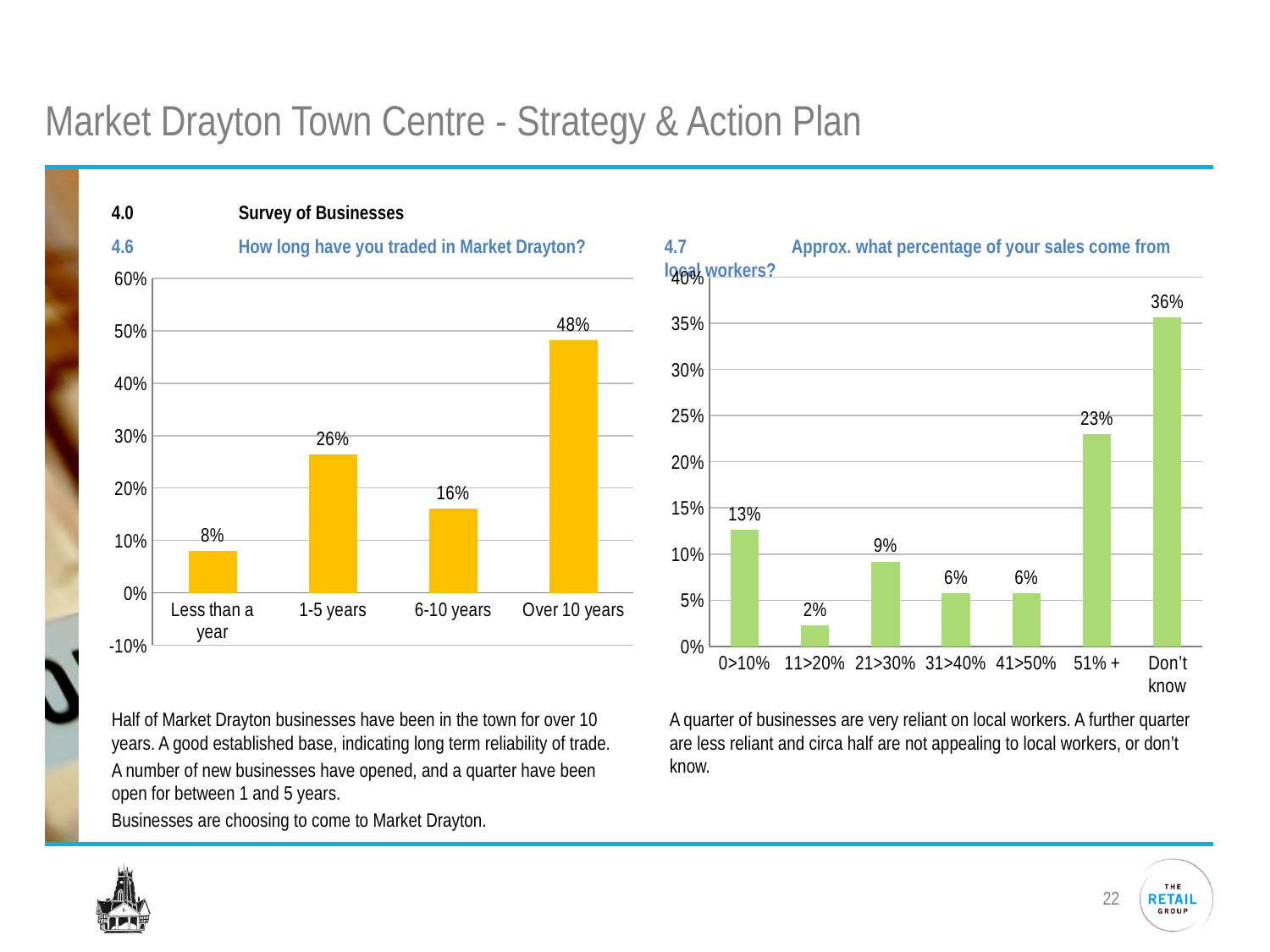
What colour are the bars in the chart 'Approx. what percentage of your sales come from local workers?'? Green In the chart 'Approx. what percentage of your sales come from local workers?', which category has the lowest value? 11>20% In the chart 'Approx. what percentage of your sales come from local workers?', what is the difference between 'Don't know' and '51% +'? 13% In the chart 'Approx. what percentage of your sales come from local workers?', which category has the highest value? Don't know In the chart 'How long have you traded in Market Drayton?', which category has the lowest value? Less than a year In the chart 'Approx. what percentage of your sales come from local workers?', what is the value for '51% +'? 23% What kind of chart is 'How long have you traded in Market Drayton?'? Bar chart In the chart 'Approx. what percentage of your sales come from local workers?', which is larger: '0>10%' or '21>30%'? 0>10% In the chart 'How long have you traded in Market Drayton?', what is the value for 'Over 10 years'? 48% In the chart 'How long have you traded in Market Drayton?', what is the difference between '1-5 years' and '6-10 years'? 10% In the chart 'Approx. what percentage of your sales come from local workers?', how many categories are shown? 7 In the chart 'How long have you traded in Market Drayton?', how many categories are shown? 4